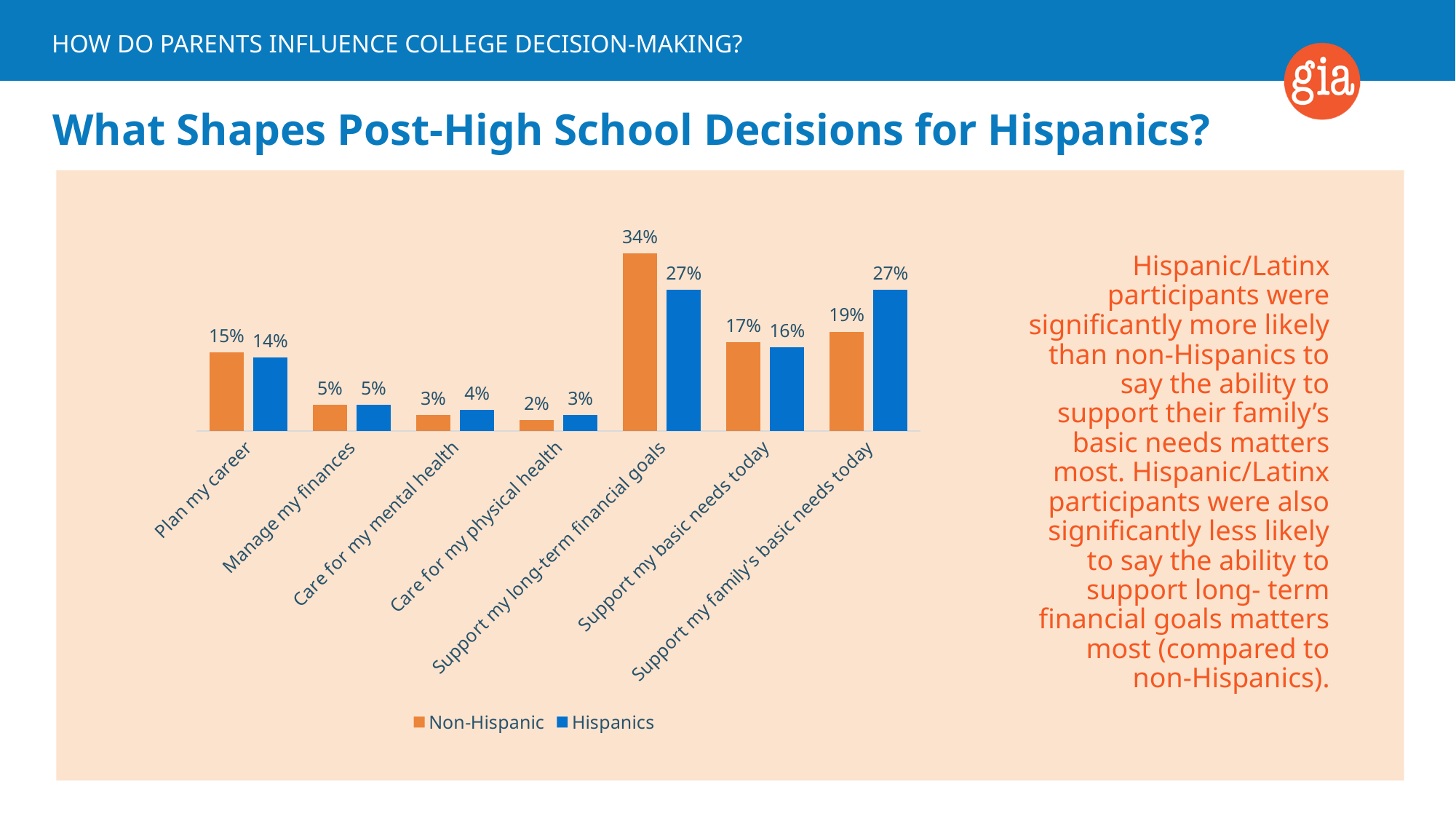
What is the Hispanics value for "Plan my career"? 14% How many categories are shown on the x axis of the chart? 7 How many series does the chart's legend list? 2 What is the Non-Hispanic value for "Support my long-term financial goals"? 34% What kind of chart is shown on the slide? Bar chart What is the Hispanics value for "Support my family's basic needs today"? 27% What is the difference between the Hispanics and Non-Hispanic values for "Support my family's basic needs today"? 8% Which category has the lowest Non-Hispanic value? Care for my physical health What is the Non-Hispanic value for "Care for my physical health"? 2% Which category has the highest Non-Hispanic value? Support my long-term financial goals For "Support my family's basic needs today", which series has the larger value, Non-Hispanic or Hispanics? Hispanics What is the difference between the Non-Hispanic and Hispanics values for "Support my long-term financial goals"? 7%